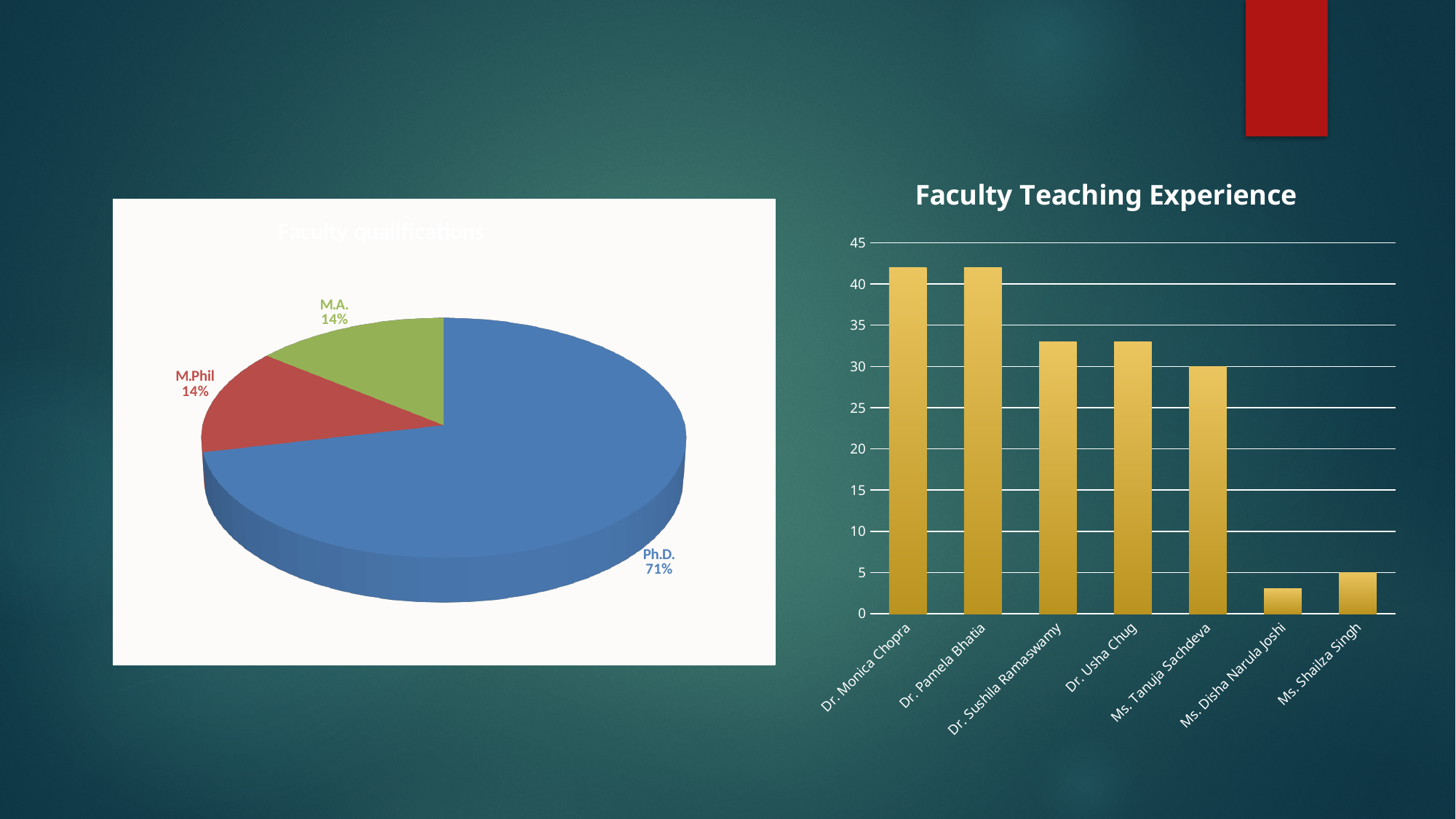
In the Faculty Teaching Experience chart, which faculty member has the lowest value? Ms. Disha Narula Joshi In the Faculty Teaching Experience chart, is the value for Dr. Monica Chopra greater or less than 40? greater In the Faculty qualifications pie chart, what is the difference in percentage points between the Ph.D. slice and the M.A. slice? 57 What kind of chart is the Faculty Teaching Experience chart? bar chart In the Faculty Teaching Experience chart, which is larger: the value for Ms. Tanuja Sachdeva or the value for Ms. Shailza Singh? Ms. Tanuja Sachdeva In the Faculty qualifications pie chart, what colour is the Ph.D. slice? blue In the Faculty qualifications pie chart, what percentage is shown for M.Phil? 14% In the Faculty Teaching Experience chart, is the value for Dr. Usha Chug greater or less than 35? less How many slices does the Faculty qualifications pie chart have? 3 In the Faculty qualifications pie chart, which qualification has the largest slice? Ph.D. In the Faculty qualifications pie chart, what share of faculty hold a Ph.D.? 71% How many faculty members are shown in the Faculty Teaching Experience chart? 7